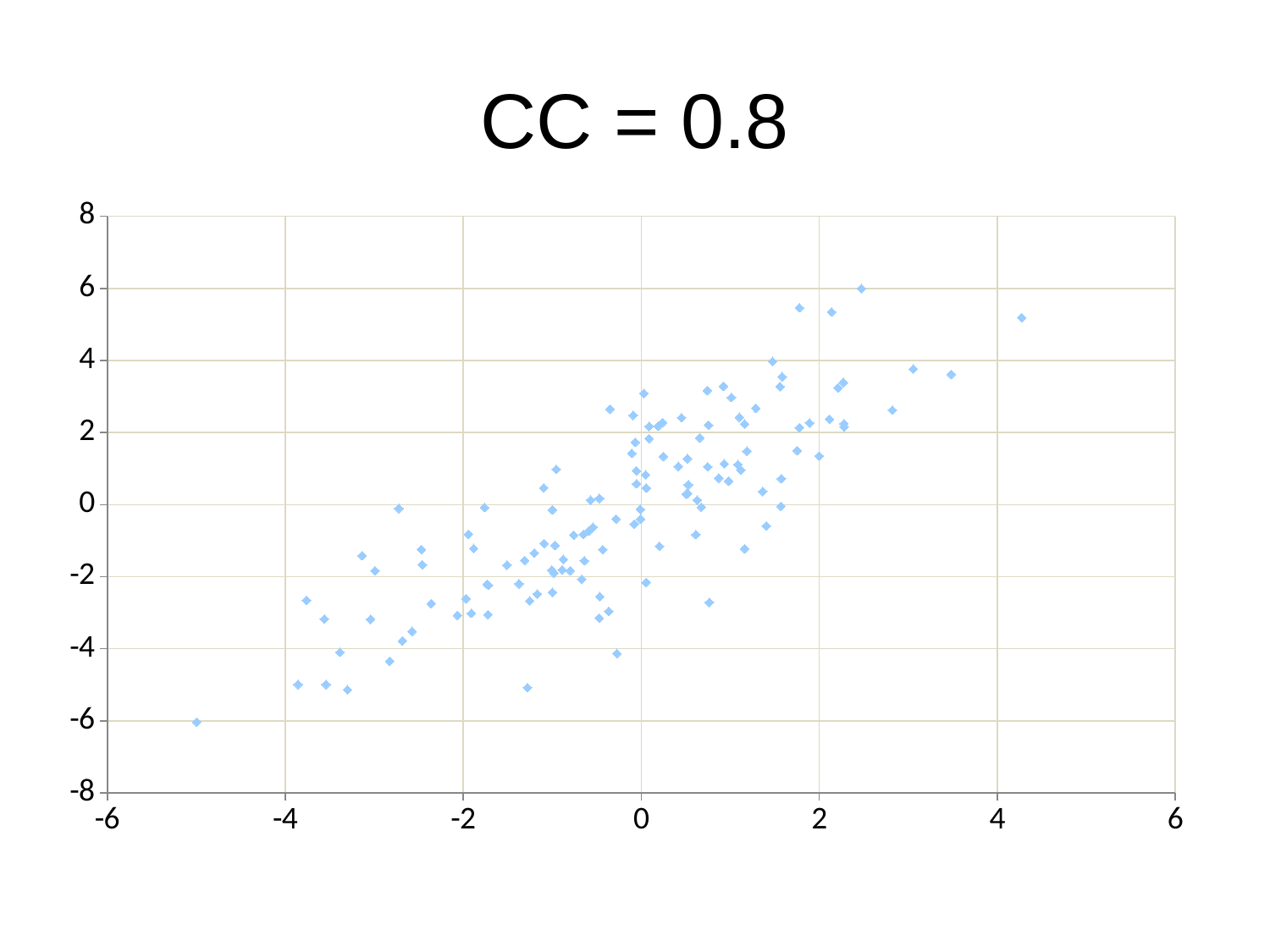
Is the y value of the highest point greater or less than 4? greater Do the plotted points generally rise or fall as the x value increases? rise Is the y value of the rightmost point greater or less than 6? less Is the x value of the lowest point greater or less than -4? less What kind of chart is shown on the slide? scatter plot What is the title of the chart? CC = 0.8 What is the maximum value shown on the x axis? 6